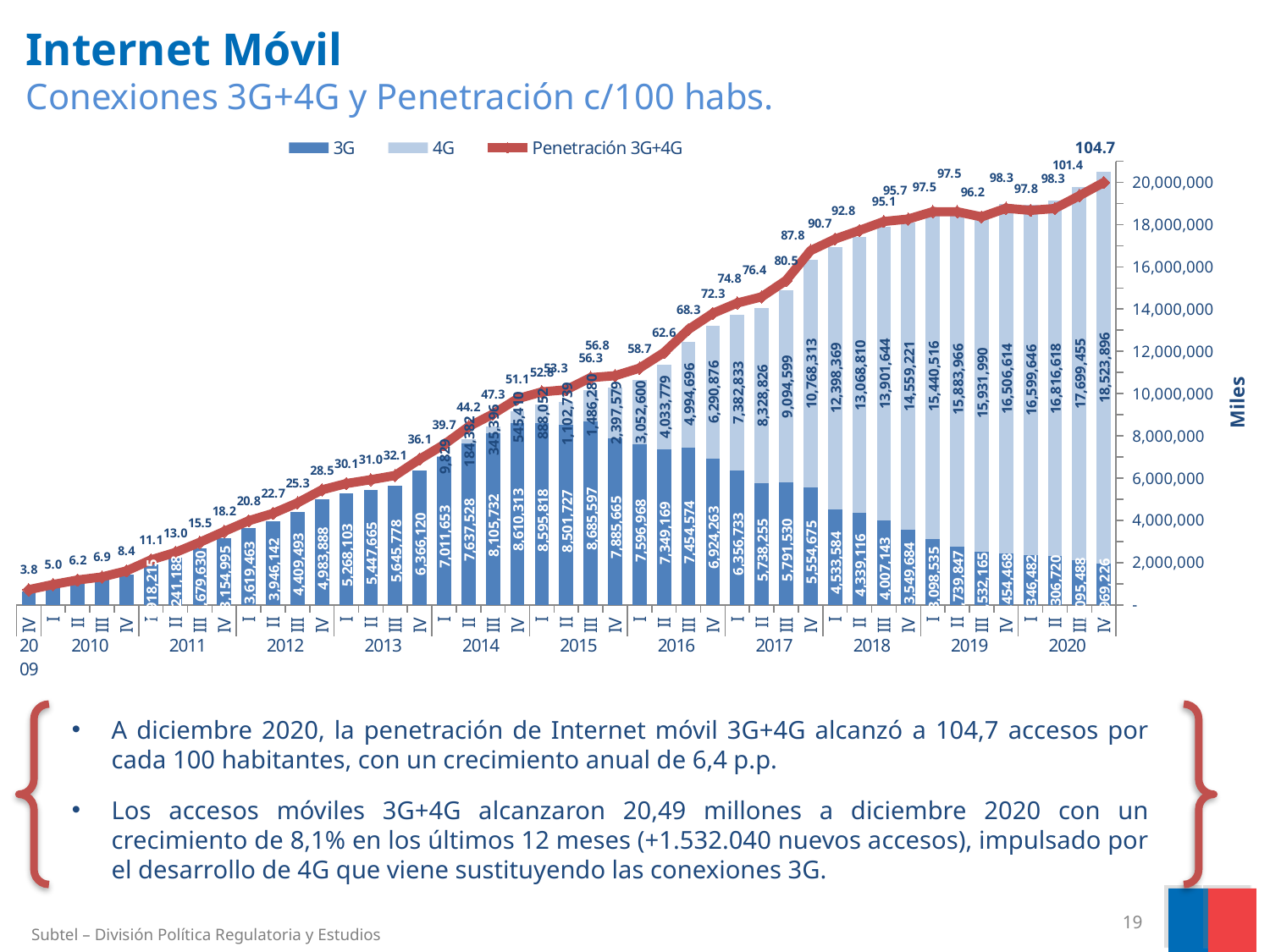
By how much did Penetración 3G+4G increase from IV 2019 (98.3) to IV 2020 (104.7)? 6.4 In which quarter does the Penetración 3G+4G line reach its highest value? IV 2020 What is the Penetración 3G+4G value for IV 2020? 104.7 Does the Penetración 3G+4G line generally rise or fall from IV 2009 to IV 2020? Rise What is the Penetración 3G+4G value at the first point, IV 2009? 3.8 In which quarter is the 3G value highest? III 2015 In IV 2020, which is larger, the 3G segment or the 4G segment? 4G What is the 3G value for I 2014? 7,011,653 What kind of chart is this? Stacked bar chart combined with a line How many series does the legend list? 3 What is the 4G value for IV 2020? 18,523,896